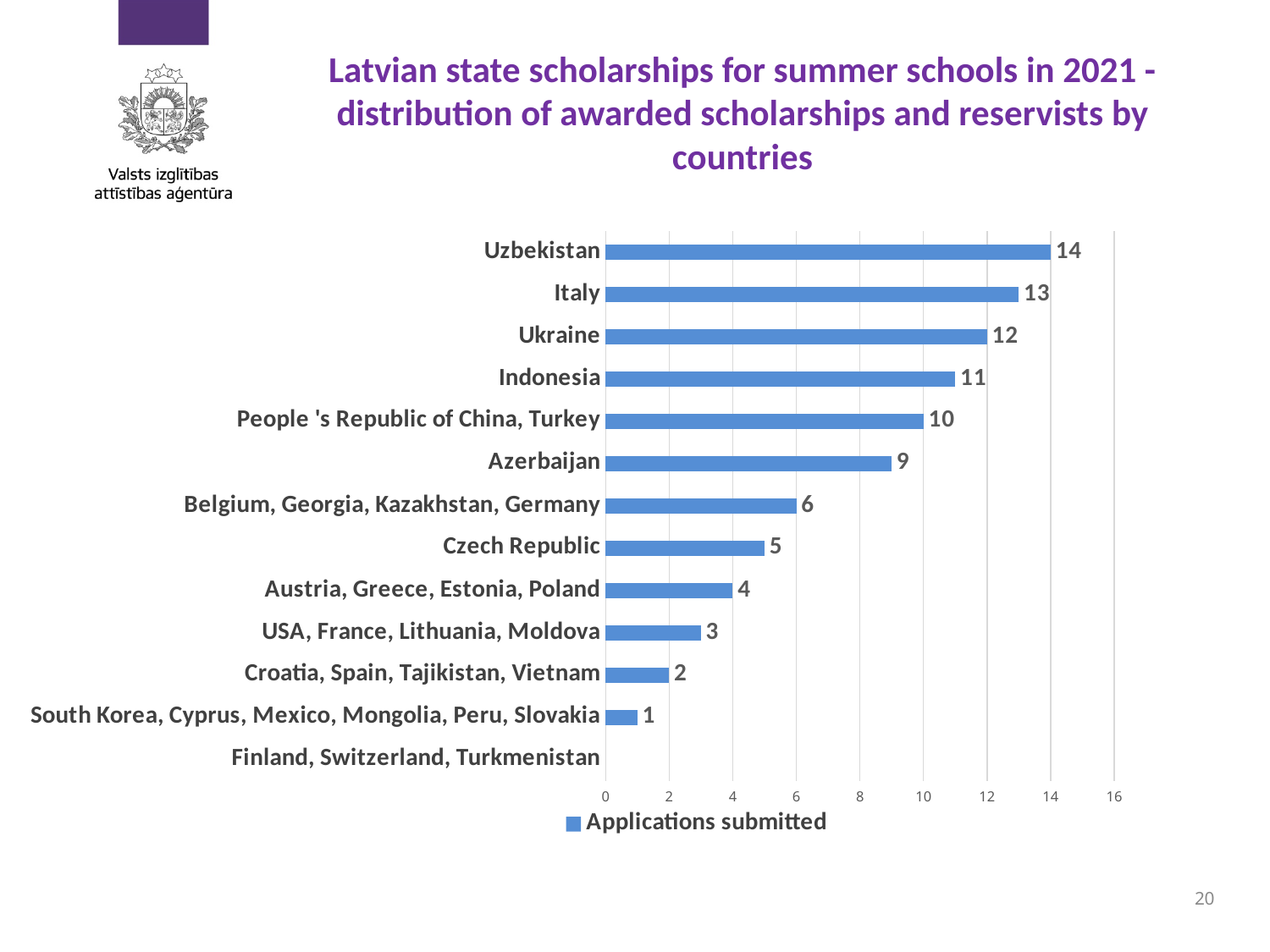
How many categories are shown on the chart? 13 What is the value for Czech Republic? 5 How many series does the legend list? 1 Which category has the highest value? Uzbekistan What kind of chart is shown on the slide? bar chart What is the legend entry of the chart? Applications submitted What is the difference between the values for Italy and Ukraine? 1 What is the difference between the values for Indonesia and Czech Republic? 6 What is the value for Azerbaijan? 9 What is the value for Uzbekistan? 14 Is the value for Ukraine greater or less than 10? greater Which is larger, the value for Indonesia or the value for Azerbaijan? Indonesia